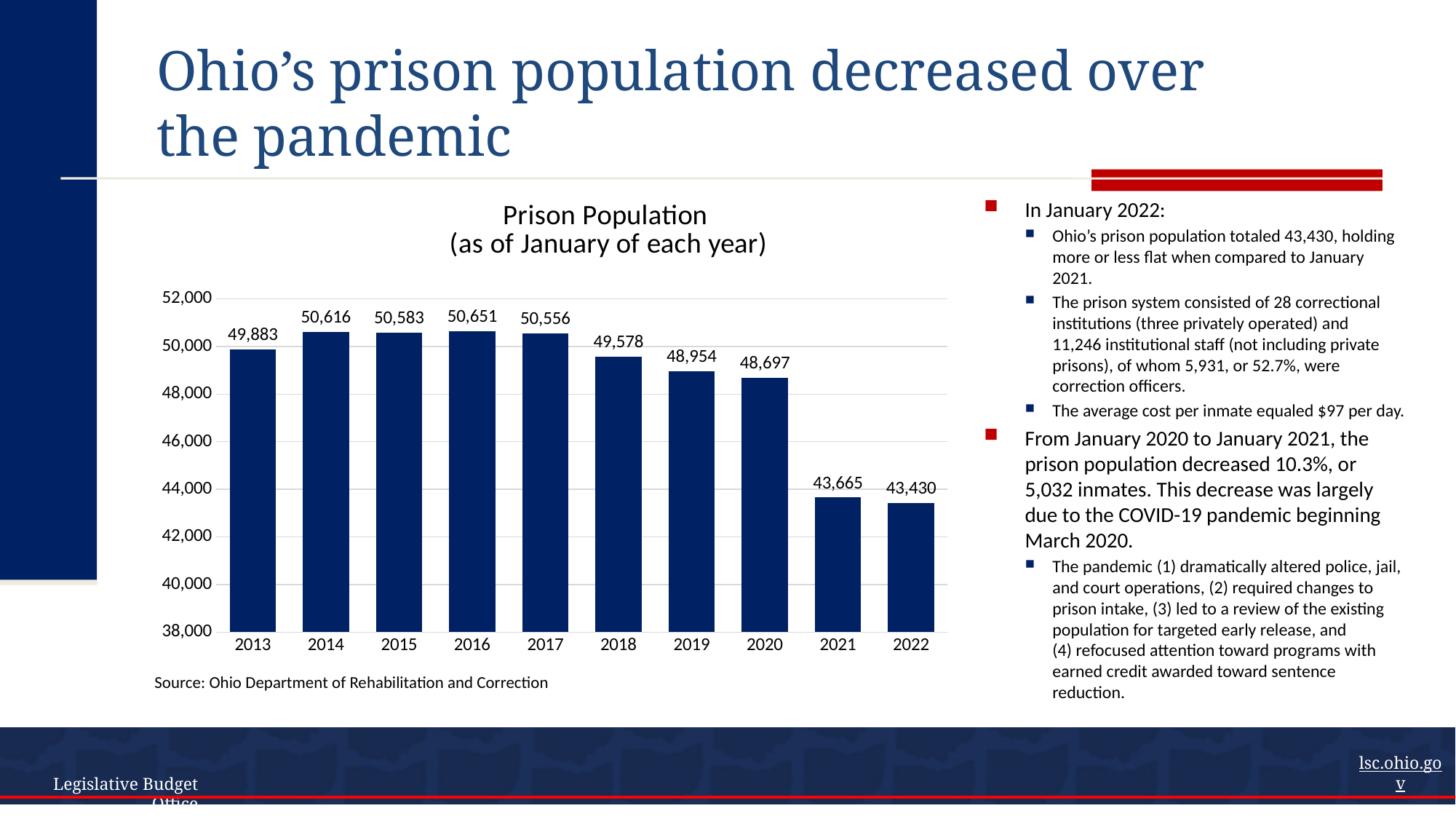
Which year had a larger prison population, 2018 or 2019? 2018 What was the prison population in January 2021? 43,665 Is the prison population for 2021 greater or less than 44,000? less What was the prison population in January 2016? 50,651 How many years are shown in the chart? 10 Which year has the lowest prison population in the chart? 2022 What is the difference between the prison population in 2013 and in 2022? 6,453 By how much did the prison population fall from January 2020 to January 2021? 5,032 What was the prison population in January 2013? 49,883 Does the prison population generally rise or fall from 2016 to 2022? fall What kind of chart is used to show the prison population? bar chart Which year has the highest prison population in the chart? 2016